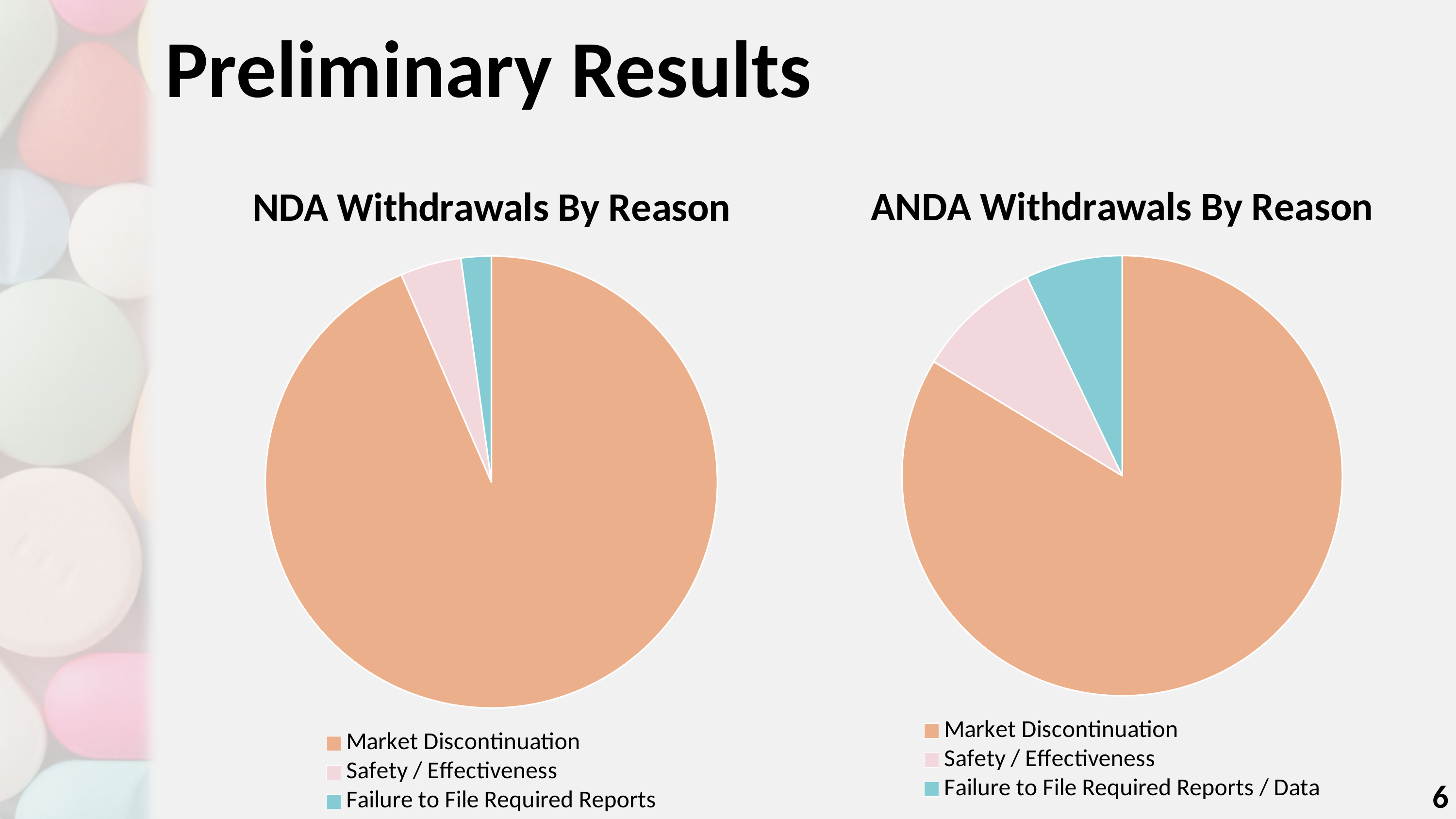
In the 'ANDA Withdrawals By Reason' chart, which reason has the largest slice? Market Discontinuation In the 'ANDA Withdrawals By Reason' chart, which slice is larger: Safety / Effectiveness or Failure to File Required Reports / Data? Safety / Effectiveness How many slices does the 'ANDA Withdrawals By Reason' pie chart have? 3 What kind of chart is the 'ANDA Withdrawals By Reason' chart? pie chart In the 'ANDA Withdrawals By Reason' chart, what colour is the Failure to File Required Reports / Data slice? teal In the 'NDA Withdrawals By Reason' chart, which reason has the smallest slice? Failure to File Required Reports What kind of chart is the 'NDA Withdrawals By Reason' chart? pie chart In the 'ANDA Withdrawals By Reason' chart, which reason has the smallest slice? Failure to File Required Reports / Data How many slices does the 'NDA Withdrawals By Reason' pie chart have? 3 How many charts are shown on the slide? 2 In the 'NDA Withdrawals By Reason' chart, which reason has the largest slice? Market Discontinuation In the 'NDA Withdrawals By Reason' chart, which slice is larger: Safety / Effectiveness or Failure to File Required Reports? Safety / Effectiveness